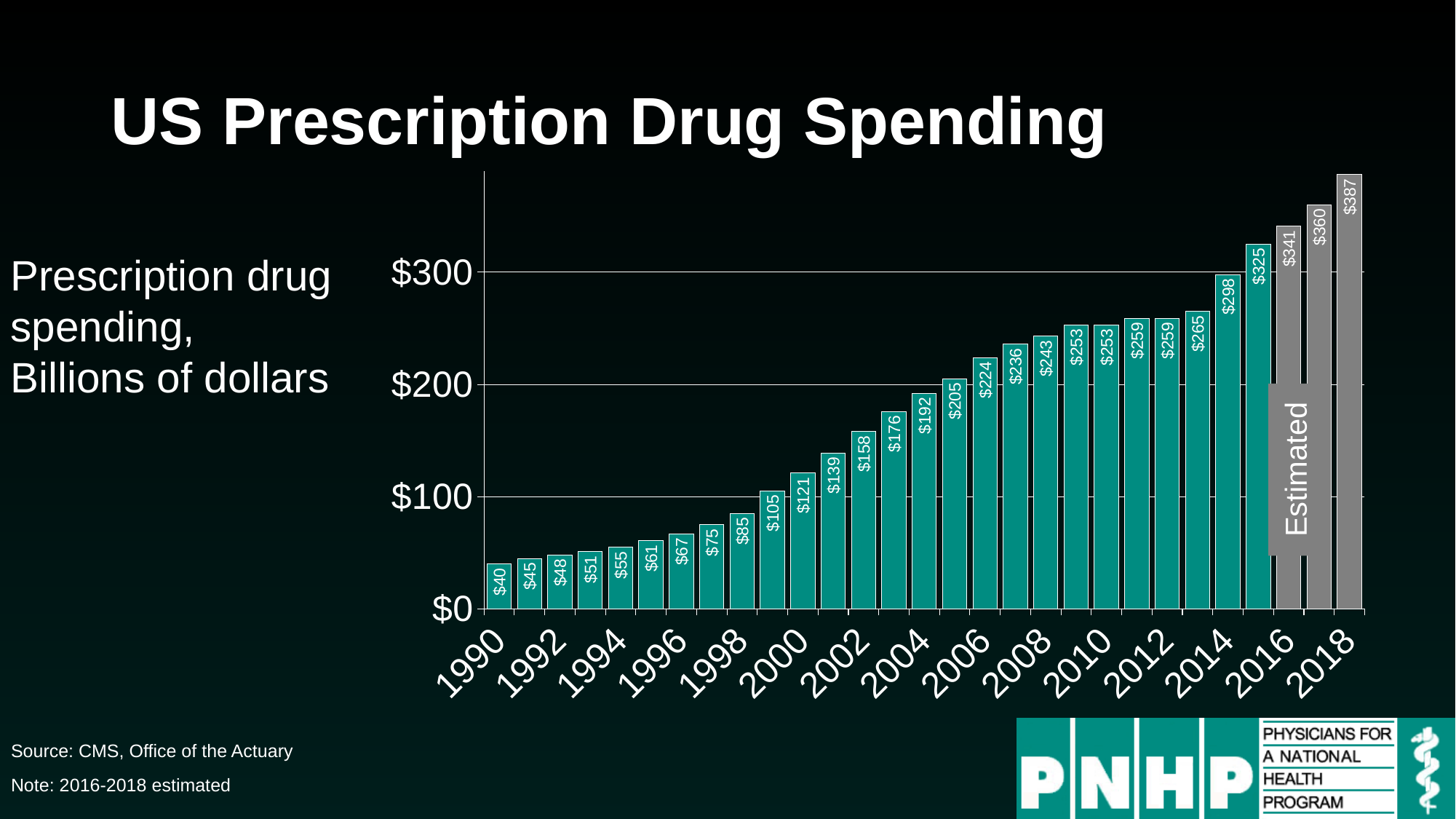
What kind of chart is shown? Bar chart What is the value for 1990? $40 Which is larger, the value for 2006 or the value for 2008? 2008 What is the value for 2000? $121 Which year has the lowest value? 1990 What is the value for 2010? $253 How many bars are plotted in the chart? 29 Do the values generally rise or fall from 1990 to 2018? Rise What is the difference between the values for 2018 and 1990? $347 Which years are marked as estimated in the chart? 2016-2018 Which year has the highest value? 2018 What is the value for 2018? $387